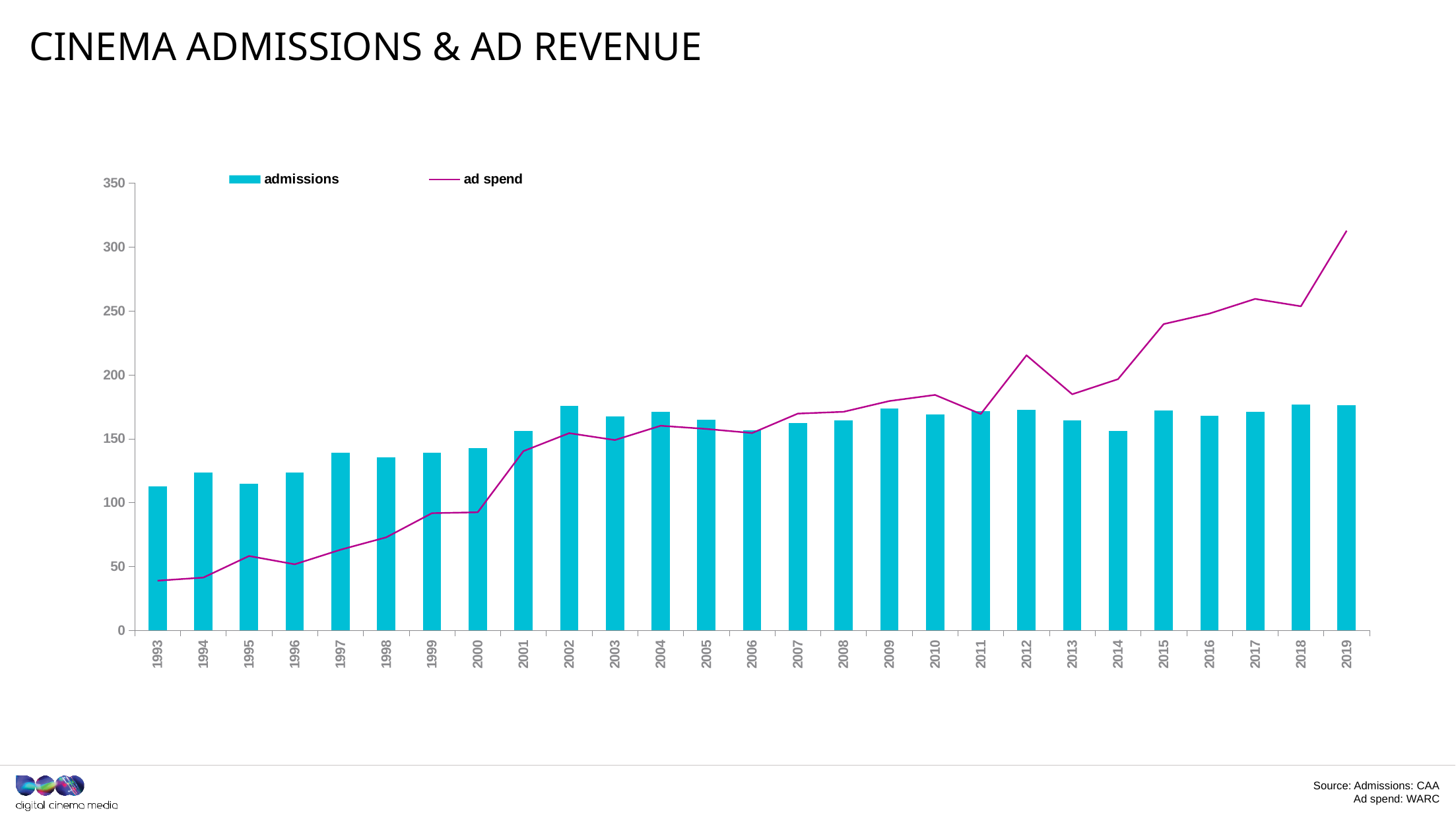
Which year has the highest ad spend value? 2019 How many years are shown along the x axis? 27 Which year has the larger ad spend value, 2012 or 2013? 2012 Is the ad spend value for 1993 greater or less than 50? less Is the ad spend value for 2019 greater or less than 300? greater Is the ad spend value for 2012 greater or less than 200? greater Does the ad spend line generally rise or fall from 1993 to 2019? rise How many series does the legend list? 2 In 2019, which is larger: admissions or ad spend? ad spend What kind of chart is shown on the slide? A combined bar and line chart